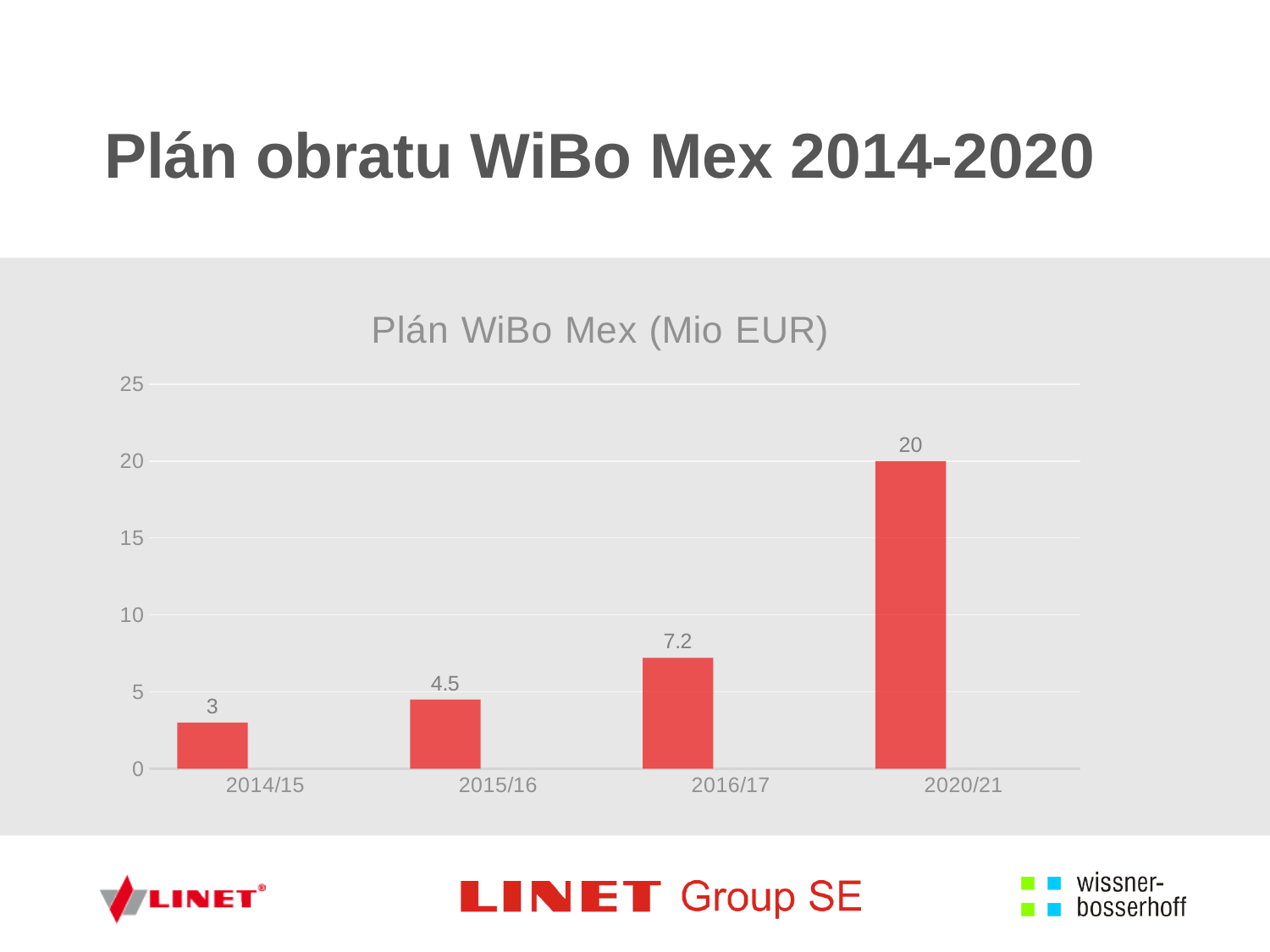
Which category has the highest value? 2020/21 What is the value for 2015/16? 4.5 What is the value for 2016/17? 7.2 What kind of chart is shown on the slide? bar chart Which is larger, the value for 2016/17 or the value for 2015/16? 2016/17 How many categories are shown on the x axis? 4 What is the difference between the values for 2015/16 and 2014/15? 1.5 What is the value for 2014/15? 3 What is the value for 2020/21? 20 Which category has the lowest value? 2014/15 What is the difference between the values for 2020/21 and 2016/17? 12.8 Do the values rise or fall from left to right along the x axis? rise